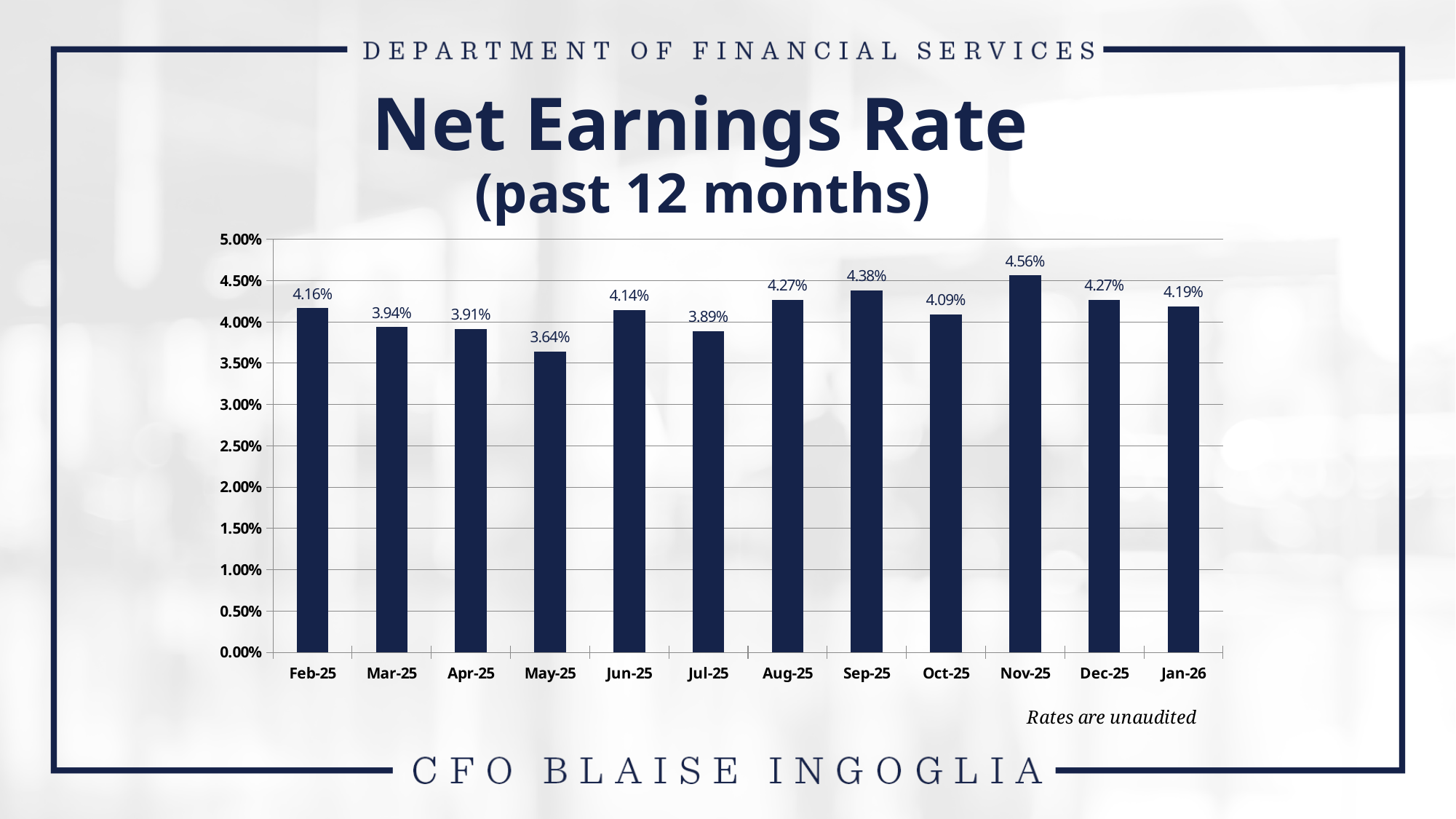
What is the net earnings rate for Nov-25? 4.56% What is the title of the chart? Net Earnings Rate (past 12 months) What is the difference between the net earnings rate in Nov-25 and May-25? 0.92% Which month has the highest net earnings rate? Nov-25 Which month has the lowest net earnings rate? May-25 What is the net earnings rate for Jan-26? 4.19% How many months are shown on the chart? 12 Which month has a higher net earnings rate, Sep-25 or Oct-25? Sep-25 Does the net earnings rate rise or fall from Feb-25 to May-25? fall What kind of chart is shown on the slide? bar chart Is the net earnings rate for Jul-25 greater or less than 4.00%? less What is the net earnings rate for May-25? 3.64%